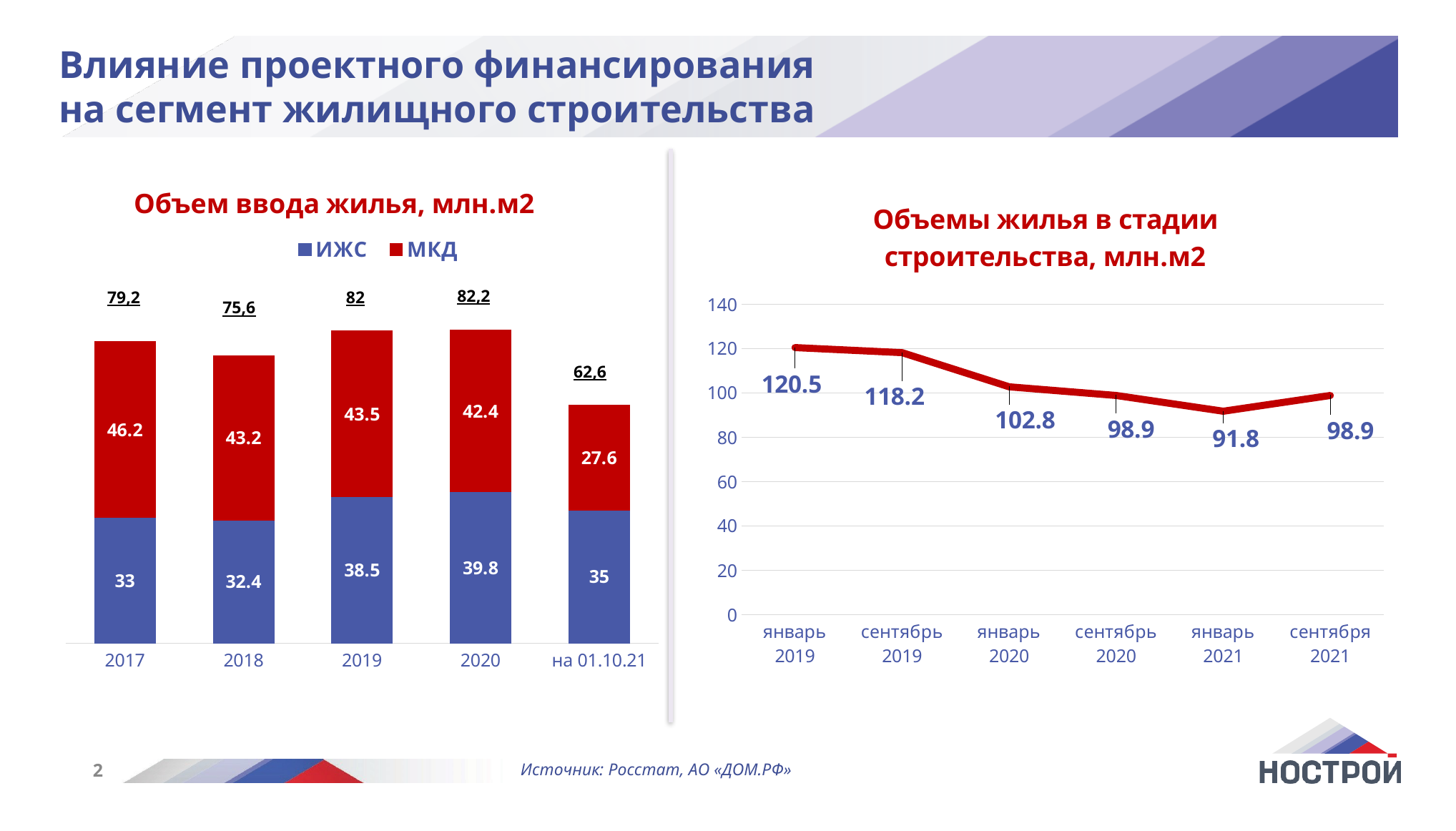
In the chart 'Объем ввода жилья, млн.м2', what is the МКД value for 2019? 43.5 What kind of chart is 'Объем ввода жилья, млн.м2'? Stacked bar chart In the chart 'Объемы жилья в стадии строительства, млн.м2', which point has the lowest value? январь 2021 In the chart 'Объем ввода жилья, млн.м2', which category has the lowest total? на 01.10.21 In the chart 'Объем ввода жилья, млн.м2', what is the total shown above the bar for 2020? 82,2 In the chart 'Объемы жилья в стадии строительства, млн.м2', what is the value for январь 2020? 102.8 In the chart 'Объемы жилья в стадии строительства, млн.м2', what is the difference between the values for январь 2019 and сентябрь 2019? 2.3 In the chart 'Объем ввода жилья, млн.м2', which year has the highest МКД value? 2017 In the chart 'Объем ввода жилья, млн.м2', what is the ИЖС value for 2018? 32.4 How many series does the legend of the chart 'Объем ввода жилья, млн.м2' list? 2 How many data points are plotted in the chart 'Объемы жилья в стадии строительства, млн.м2'? 6 In the chart 'Объем ввода жилья, млн.м2', what is the difference between the ИЖС values for 2020 and 2017? 6.8